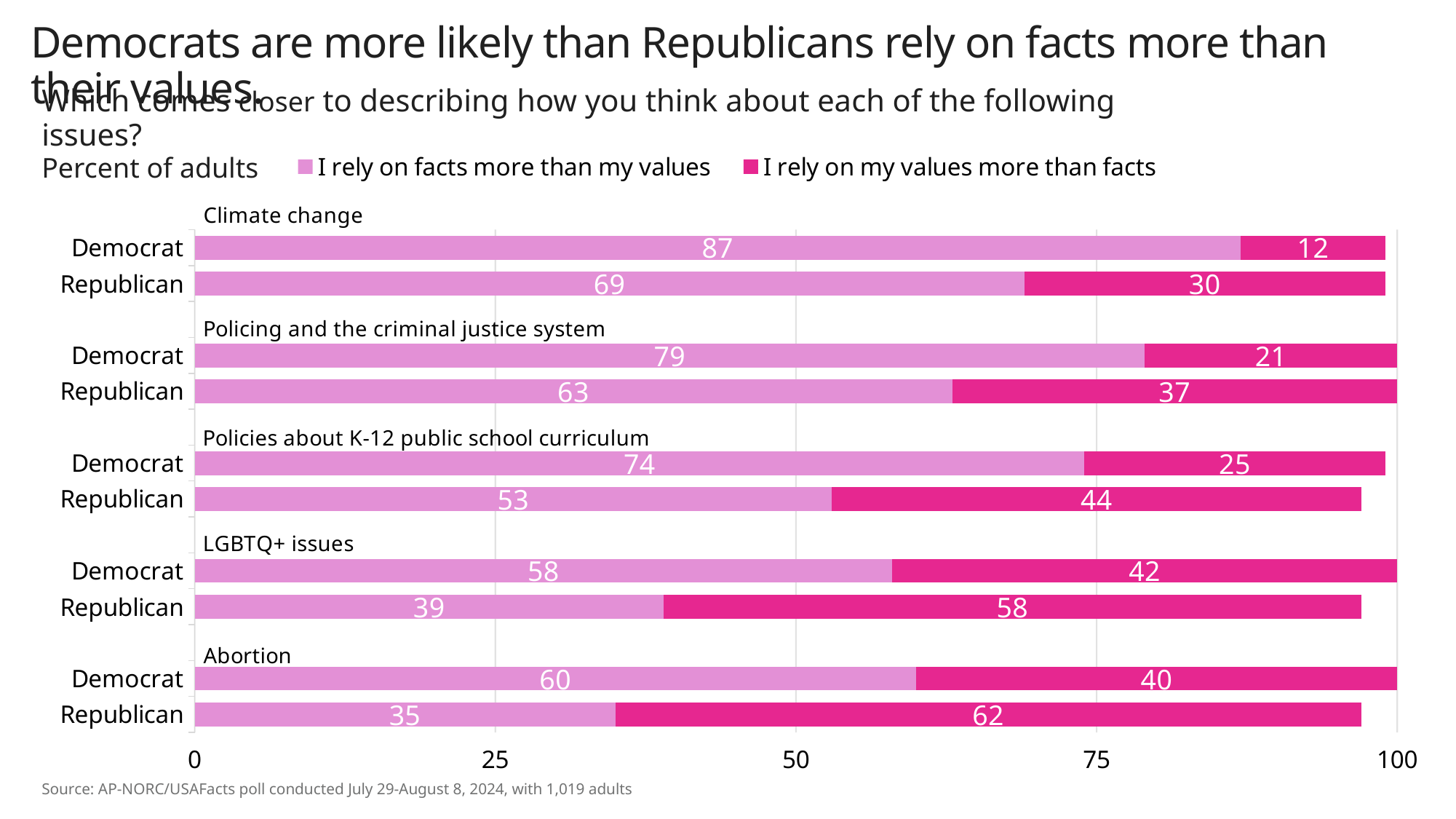
What is the difference between the percent of Democrats and Republicans who rely on facts more than values on policies about K-12 public school curriculum? 21 On which issue is the share of Democrats relying on facts more than values the highest? Climate change Who has a larger share relying on values more than facts on LGBTQ+ issues, Democrats or Republicans? Republicans What percent of Republicans say they rely on facts more than their values on LGBTQ+ issues? 39 What kind of chart is shown on the slide? Stacked bar chart How many series does the legend list? 2 How many issues are shown in the chart? 5 What percent of Democrats say they rely on facts more than their values on climate change? 87 On which issue is the share of Republicans relying on facts more than values the lowest? Abortion What percent of Democrats say they rely on their values more than facts on policing and the criminal justice system? 21 What is the total of the Republican bar for climate change (facts plus values)? 99 What percent of Republicans say they rely on their values more than facts on abortion? 62